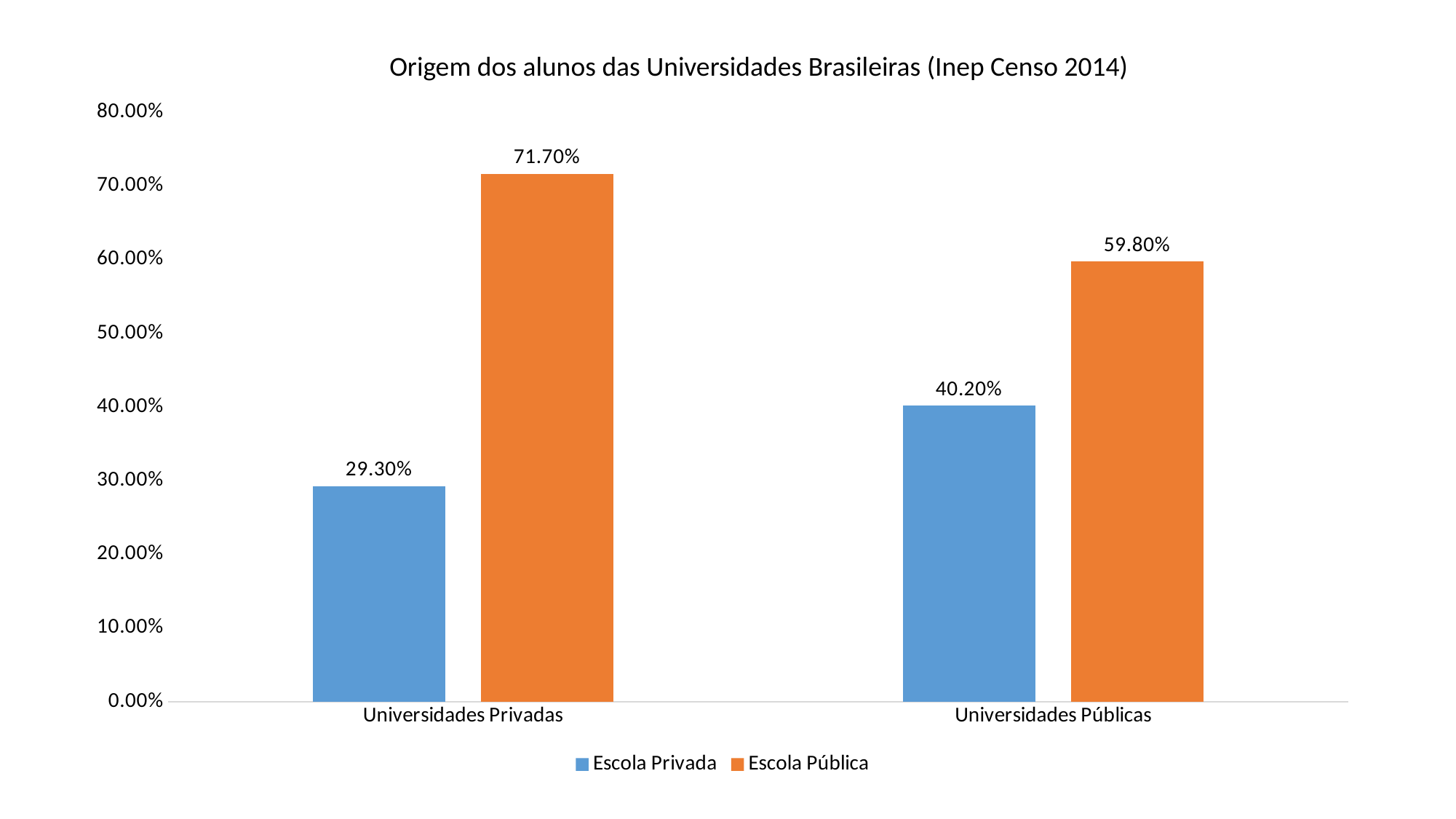
What is the value for Escola Privada at Universidades Privadas? 29.30% How many series does the legend list? 2 What is the value for Escola Pública at Universidades Privadas? 71.70% What is the difference between Escola Pública and Escola Privada at Universidades Privadas? 42.40% What is the title of the chart? Origem dos alunos das Universidades Brasileiras (Inep Censo 2014) Which bar has the highest value on the chart? Escola Pública at Universidades Privadas What is the value for Escola Privada at Universidades Públicas? 40.20% How many categories are shown on the x axis? 2 What is the difference between Escola Pública and Escola Privada at Universidades Públicas? 19.60% Which bar has the lowest value on the chart? Escola Privada at Universidades Privadas Which is larger: Escola Privada at Universidades Públicas or Escola Privada at Universidades Privadas? Escola Privada at Universidades Públicas What is the value for Escola Pública at Universidades Públicas? 59.80%